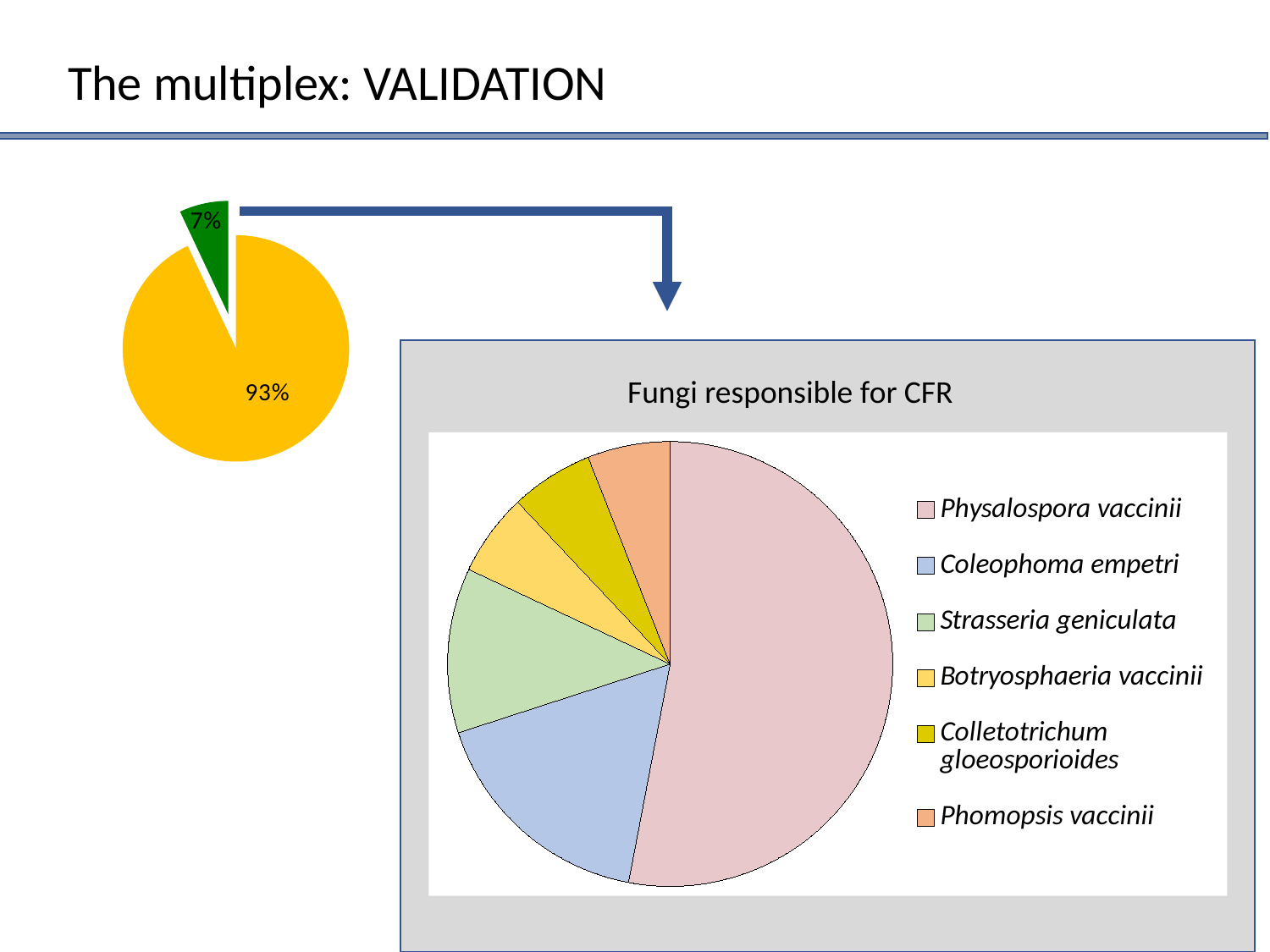
What is the title of the pie chart on the right of the slide? Fungi responsible for CFR How many entries does the legend of the 'Fungi responsible for CFR' chart list? 6 In the 'Fungi responsible for CFR' chart, which slice is larger, Strasseria geniculata or Physalospora vaccinii? Physalospora vaccinii In the 'Fungi responsible for CFR' chart, which fungus has the largest slice? Physalospora vaccinii In the 'Fungi responsible for CFR' chart, which slice is larger, Physalospora vaccinii or Coleophoma empetri? Physalospora vaccinii In the 'Fungi responsible for CFR' chart, which fungus is shown in orange according to the legend? Phomopsis vaccinii On the small pie chart on the left of the slide, what is the difference between the two slice values? 86% On the small pie chart on the left of the slide, which slice is larger, the green one or the yellow one? the yellow one On the small pie chart on the left of the slide, how many slices are there? 2 On the small pie chart on the left of the slide, what value is shown for the yellow slice? 93% What kind of chart is the chart titled 'Fungi responsible for CFR'? pie chart On the small pie chart on the left of the slide, what value is shown for the green slice? 7%